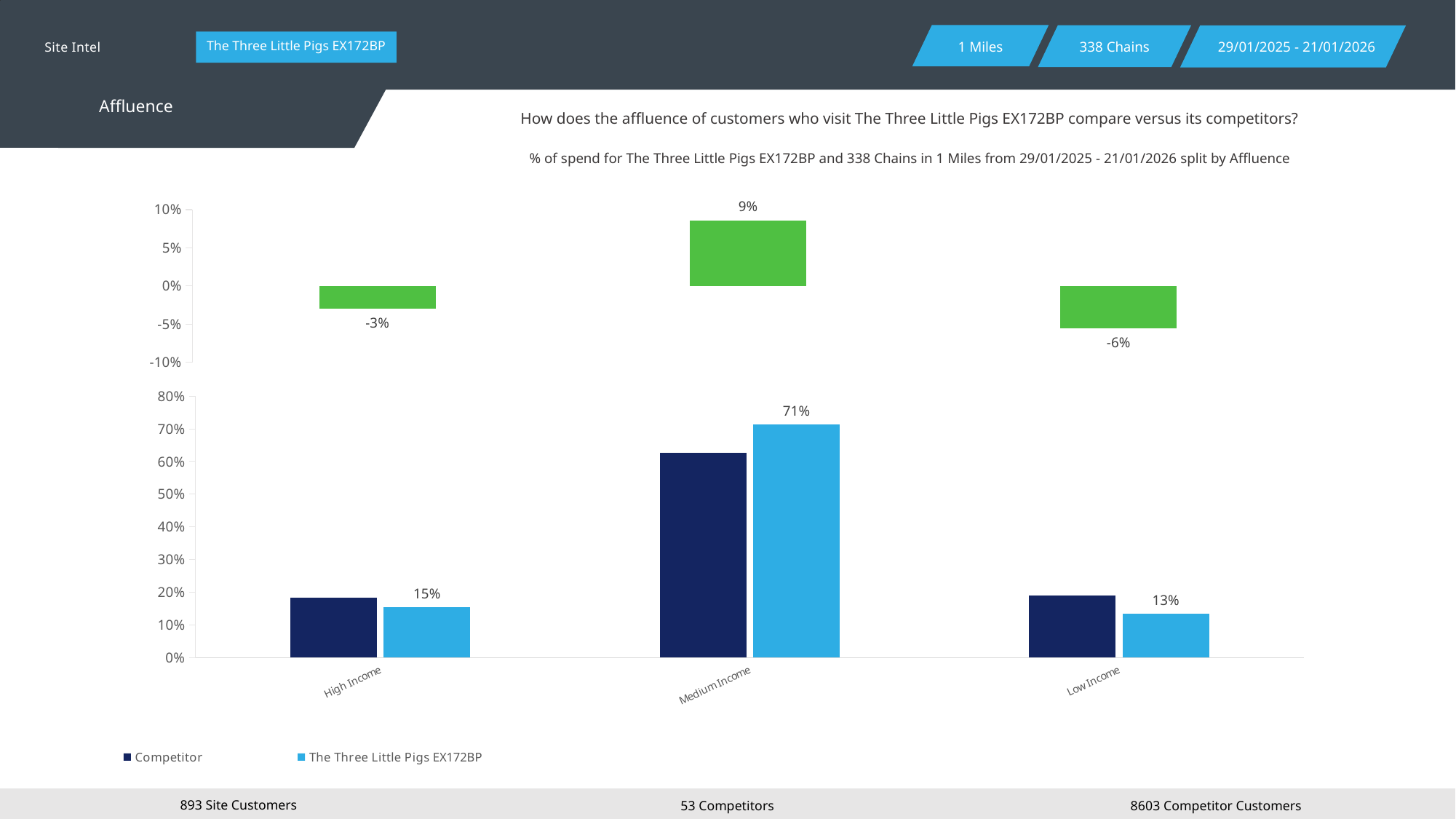
In the top chart, what is the value shown for the Medium Income category? 9% In the bottom chart, for High Income, which series has the larger value, Competitor or The Three Little Pigs EX172BP? Competitor In the top chart, which category has the lowest value? Low Income In the bottom chart, what is the difference between The Three Little Pigs EX172BP values for Medium Income and High Income? 56% In the bottom chart, what is the value for The Three Little Pigs EX172BP in the Low Income category? 13% In the top chart, what is the value shown for the Low Income category? -6% In the bottom chart, what is the value for The Three Little Pigs EX172BP in the High Income category? 15% In the bottom chart, which category has the highest value for The Three Little Pigs EX172BP? Medium Income What type of chart is the bottom chart? Bar chart In the bottom chart, is the Competitor value for Medium Income greater or less than 60%? greater In the bottom chart, what is the value for The Three Little Pigs EX172BP in the Medium Income category? 71% How many series does the legend of the bottom chart list? 2